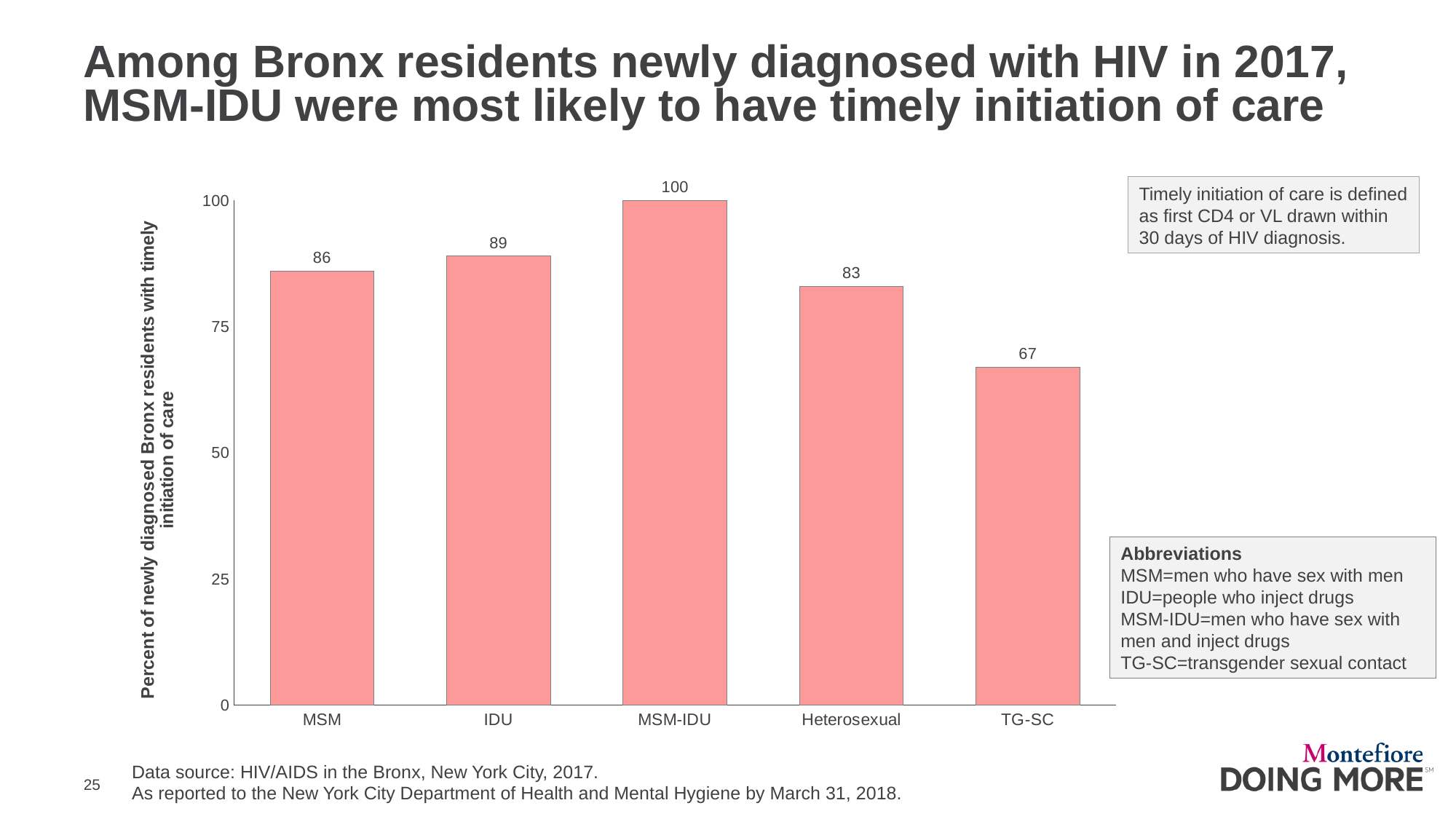
Which category has the lowest value? TG-SC What is the value for MSM-IDU? 100 Which category has the highest value? MSM-IDU Is the value for TG-SC greater or less than 75? less What is the difference between the values for IDU and MSM? 3 What is the difference between the values for MSM-IDU and TG-SC? 33 How many categories are shown on the x axis? 5 Which is larger, the value for IDU or the value for Heterosexual? IDU What is the y-axis label of the chart? Percent of newly diagnosed Bronx residents with timely initiation of care What kind of chart is shown on the slide? bar chart What is the value for Heterosexual? 83 What is the value for TG-SC? 67